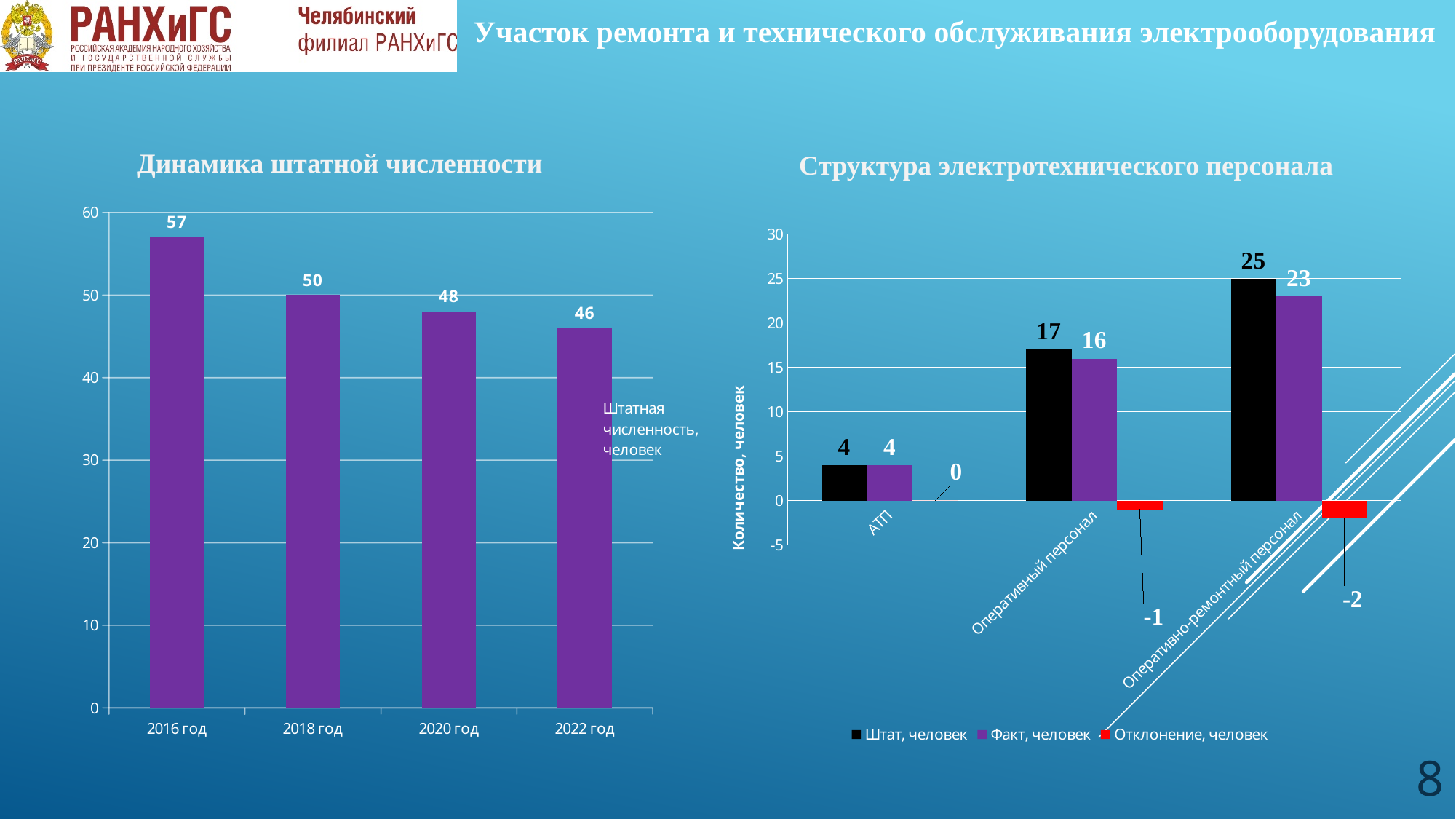
In the chart 'Динамика штатной численности', what is the difference between the values for 2016 год and 2022 год? 11 In the chart 'Динамика штатной численности', how many years are shown on the x axis? 4 In the chart 'Структура электротехнического персонала', what is the value of 'Штат, человек' for Оперативно-ремонтный персонал? 25 In the chart 'Структура электротехнического персонала', what is the value of 'Факт, человек' for Оперативный персонал? 16 In the chart 'Структура электротехнического персонала', how many series does the legend list? 3 In the chart 'Структура электротехнического персонала', which category has the lowest value of 'Штат, человек'? АТП In the chart 'Динамика штатной численности', do the values rise or fall from 2016 год to 2022 год? fall In the chart 'Структура электротехнического персонала', what is the value of 'Отклонение, человек' for Оперативно-ремонтный персонал? -2 In the chart 'Динамика штатной численности', what is the value for 2016 год? 57 In the chart 'Динамика штатной численности', what is the value for 2022 год? 46 In the chart 'Динамика штатной численности', which year has the highest value? 2016 год What kind of chart is 'Структура электротехнического персонала'? bar chart